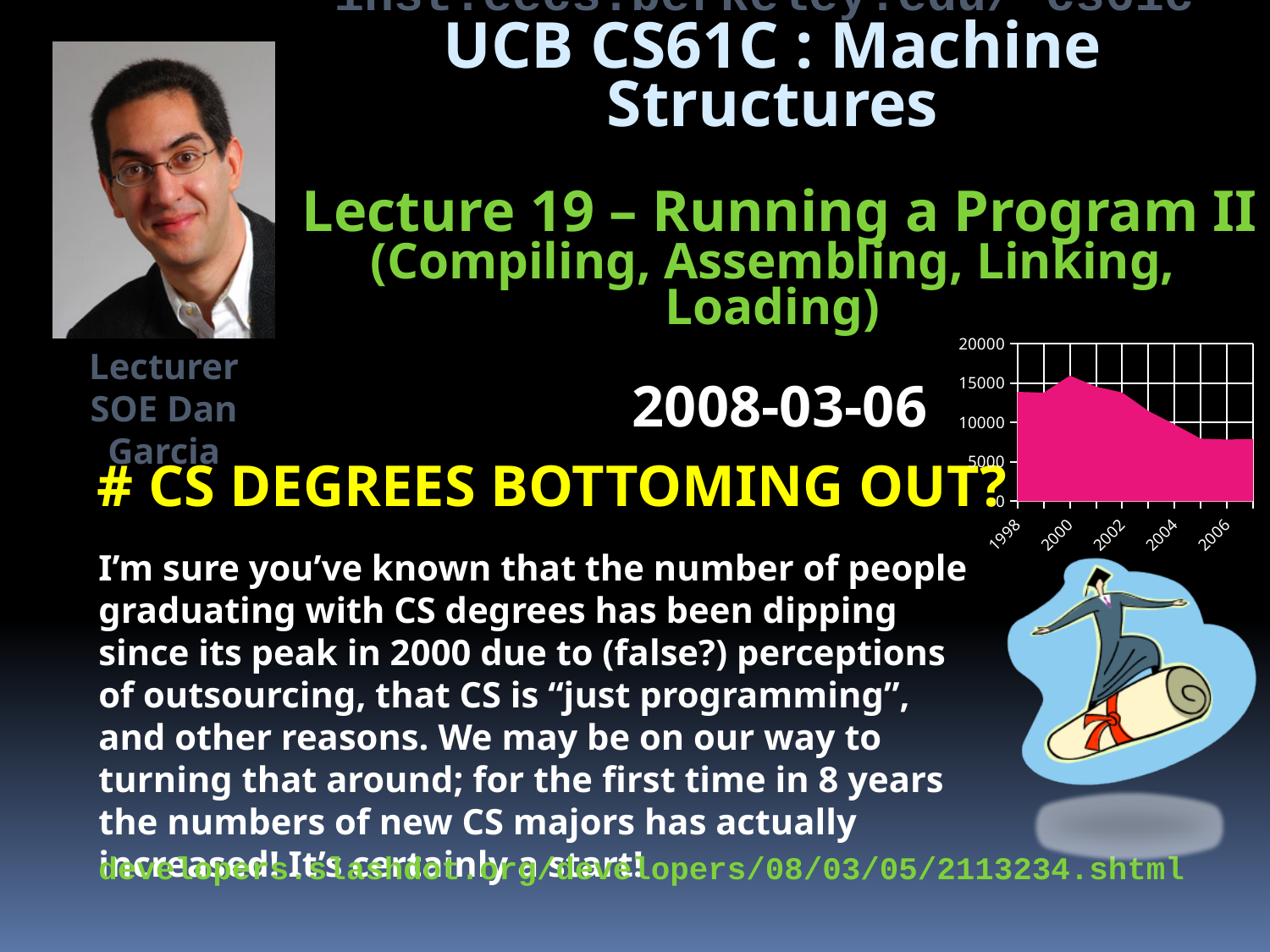
In which year does the chart reach its highest value? 2000 What kind of chart is shown in the top right of the slide? area chart What is the highest value labelled on the chart's vertical axis? 20000 Is the value for 2004 greater or less than 5000? greater Which year has the larger value, 1998 or 2006? 1998 How many year labels are shown on the chart's horizontal axis? 5 Which year has the larger value, 2000 or 2004? 2000 Is the value for 1998 greater or less than 10000? greater Is the value for 2006 greater or less than 10000? less Do the values rise or fall from 2000 to 2006? fall